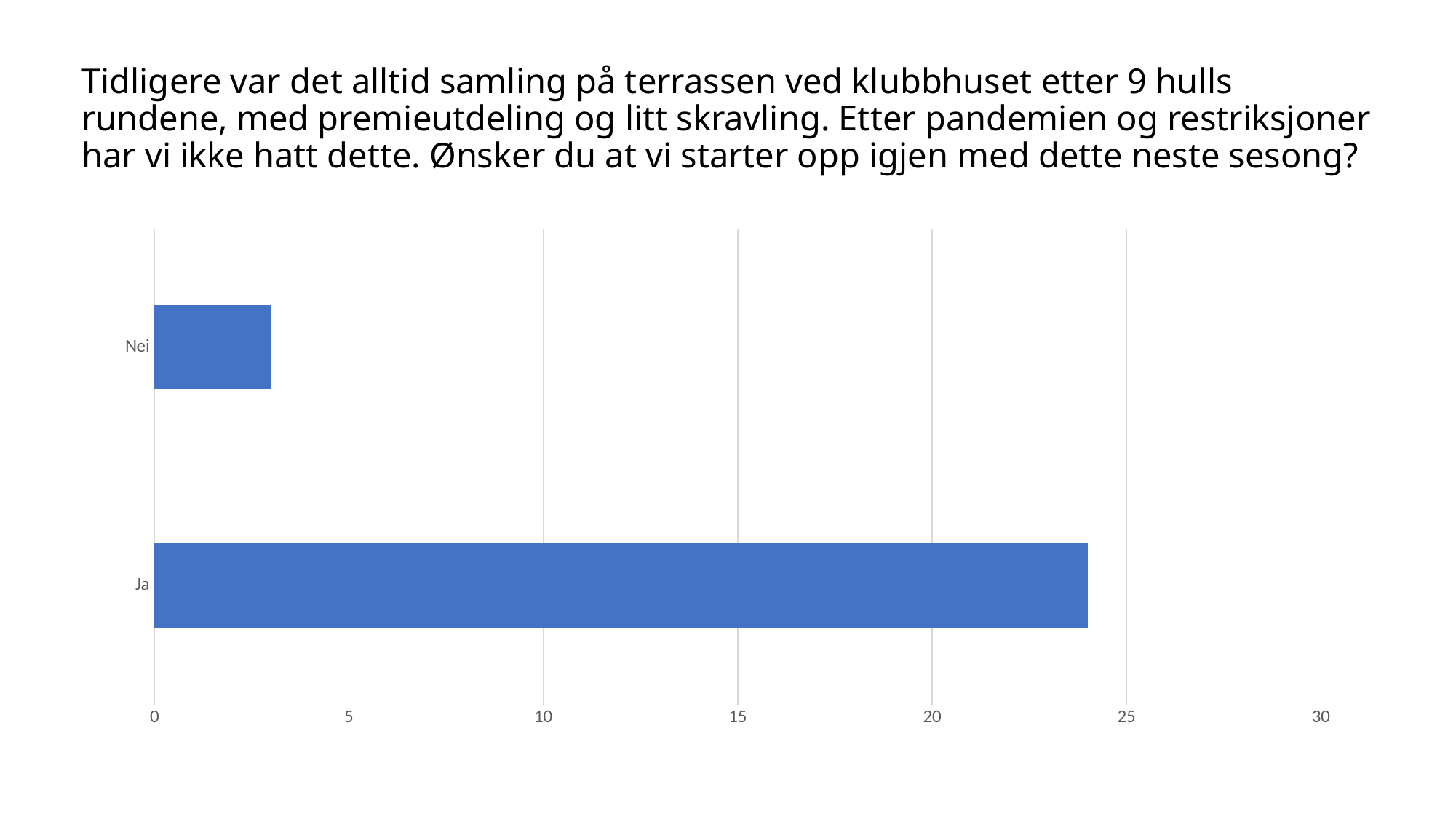
What is the highest tick value shown on the horizontal axis? 30 Which category has the lowest value? Nei Which is larger, the value for Ja or the value for Nei? Ja Is the value for Nei greater or less than 5? less What are the two category labels on the vertical axis? Nei and Ja Is the value for Ja greater or less than 20? greater How many categories are shown in the chart? 2 What kind of chart is shown on the slide? bar chart Which category has the highest value? Ja Is the value for Ja greater or less than 10? greater